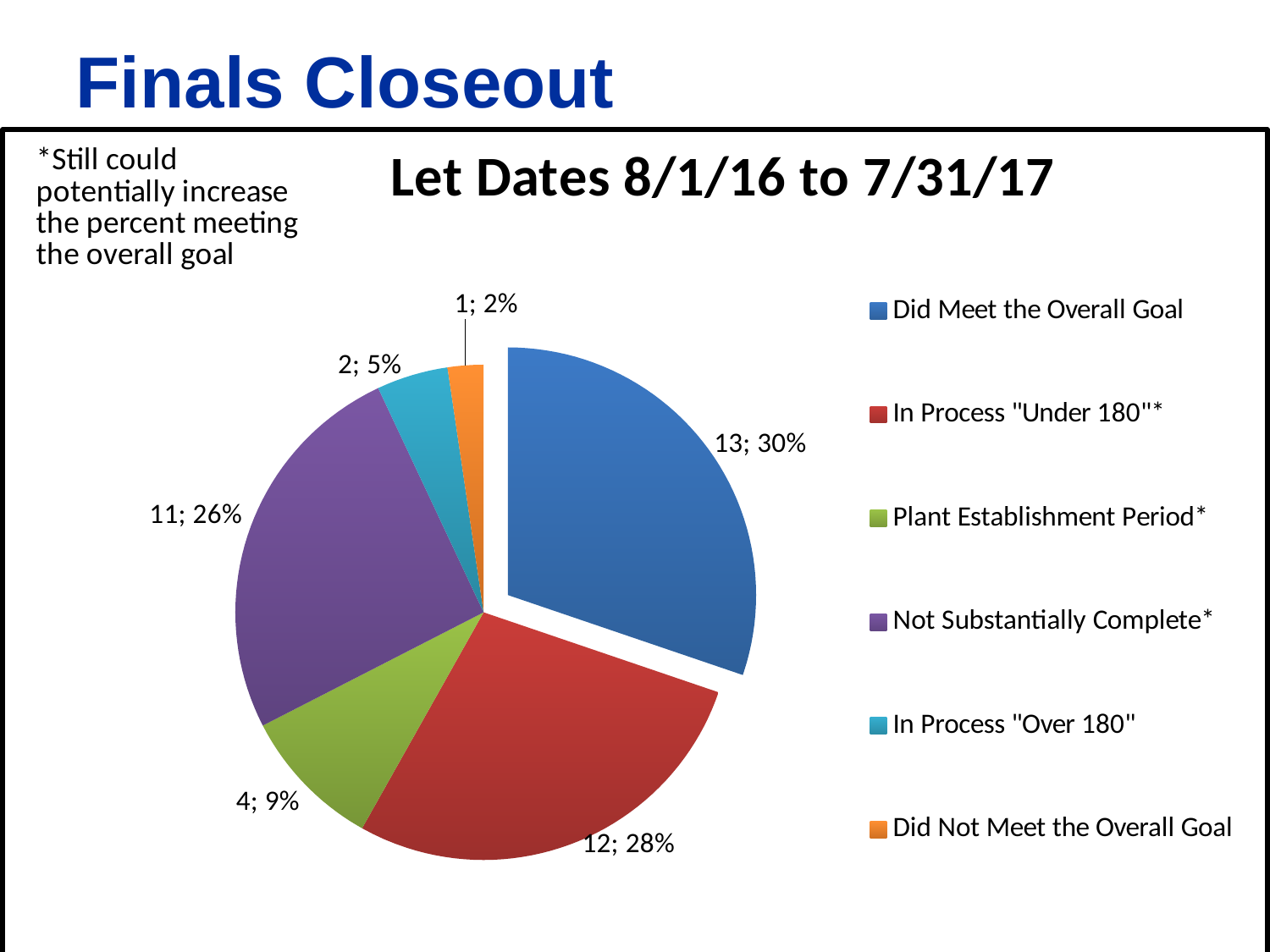
What is the difference in count between "Did Meet the Overall Goal" and "In Process "Under 180"*"? 1 What kind of chart is shown on the slide? Pie chart What is the count for "Did Meet the Overall Goal"? 13 How many categories does the legend list? 6 What colour is the slice for "In Process "Over 180""? Teal What is the count for "Not Substantially Complete*"? 11 What is the title of the chart? Let Dates 8/1/16 to 7/31/17 What percentage share does "Plant Establishment Period*" have? 9% What percentage share does "Did Meet the Overall Goal" have? 30% Which is larger, the count for "Not Substantially Complete*" or the count for "Plant Establishment Period*"? Not Substantially Complete* Which category has the largest slice? Did Meet the Overall Goal Which category has the smallest slice? Did Not Meet the Overall Goal